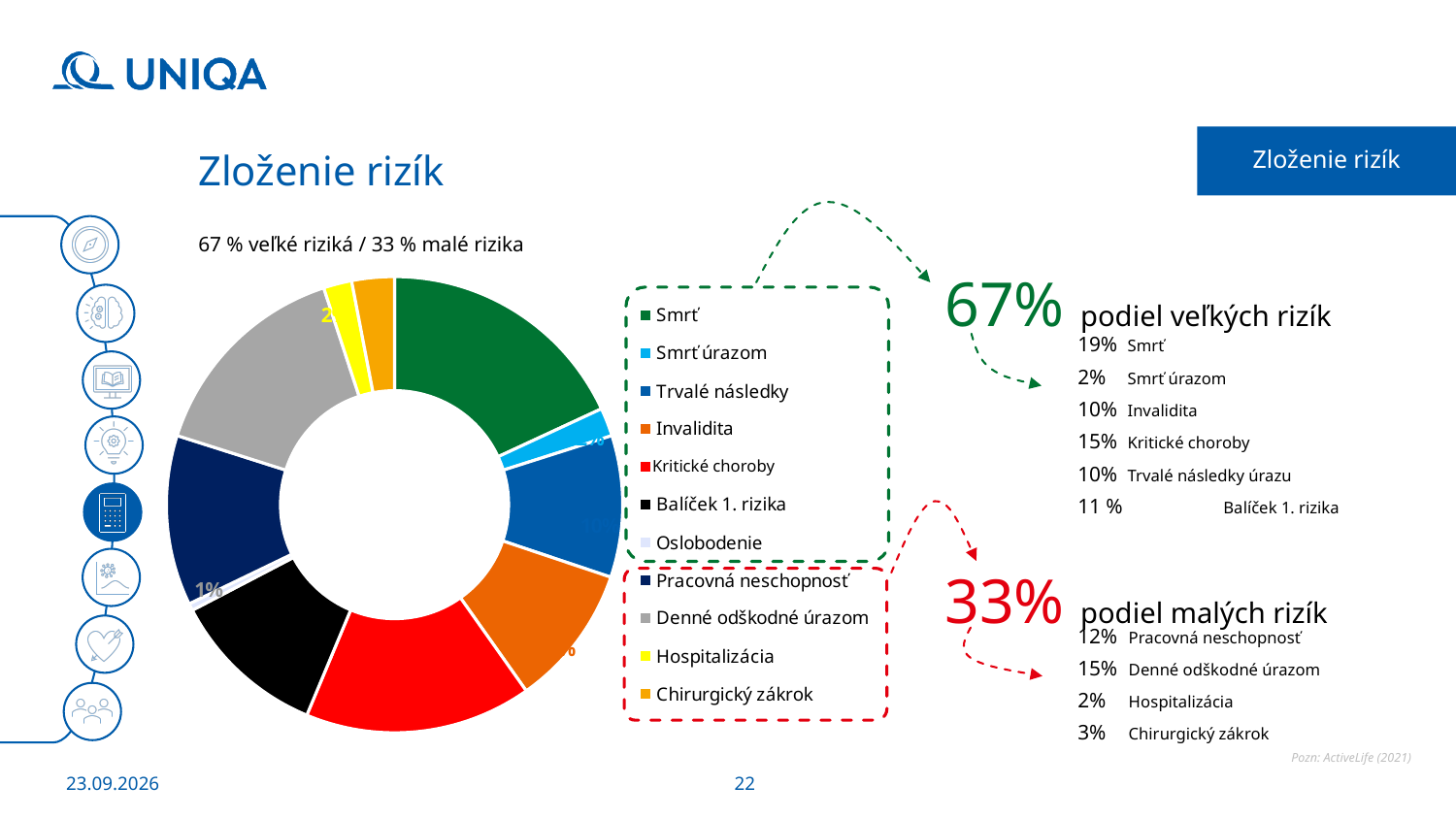
Which segment is larger, Smrť or Kritické choroby? Smrť What is the difference between the shares of Smrť (19%) and Invalidita (10%)? 9% How many entries does the chart legend list? 11 According to the slide, what share does Smrť have? 19% What colour is the Smrť segment in the chart? green What is the title of the chart on the slide? Zloženie rizík What kind of chart is shown on the slide? doughnut chart According to the slide, what share does Pracovná neschopnosť have? 12% According to the slide, what share does Kritické choroby have? 15% What is the combined share of the large risks (veľké riziká) stated on the slide? 67% According to the slide, what share does Chirurgický zákrok have? 3% Which category has the largest segment in the chart? Smrť